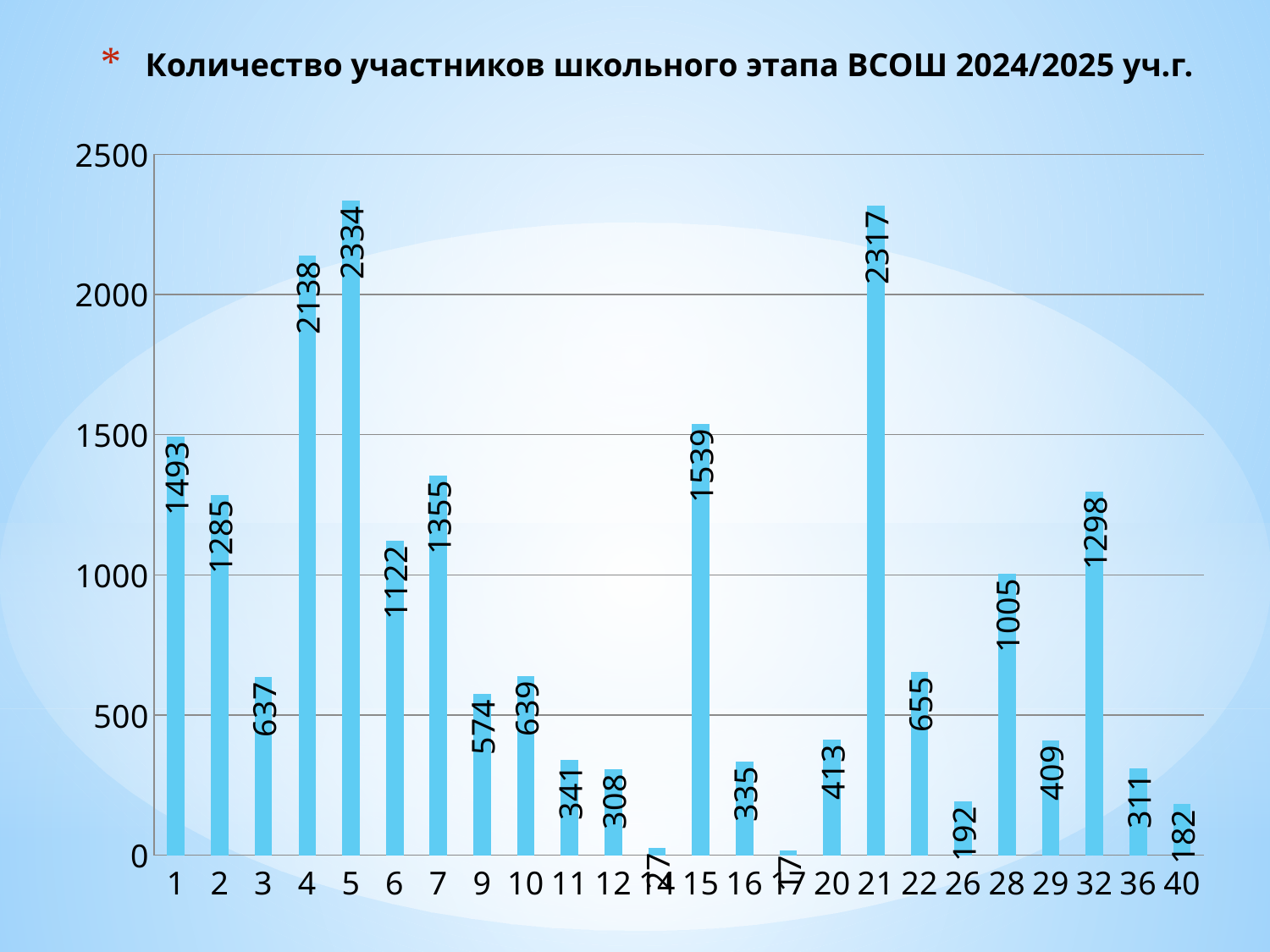
What is the difference between the values for category 14 and category 17? 10 What is the title of the chart? Количество участников школьного этапа ВСОШ 2024/2025 уч.г. What is the difference between the values for category 4 and category 5? 196 Which category has the highest value? 5 Which is larger, the value for category 1 or the value for category 15? 15 Which category has the lowest value? 17 Is the value for category 7 greater or less than 1500? less What kind of chart is shown on the slide? bar chart How many categories are shown on the x axis? 24 What is the value for category 28? 1005 What is the value for category 5? 2334 What is the value for category 21? 2317